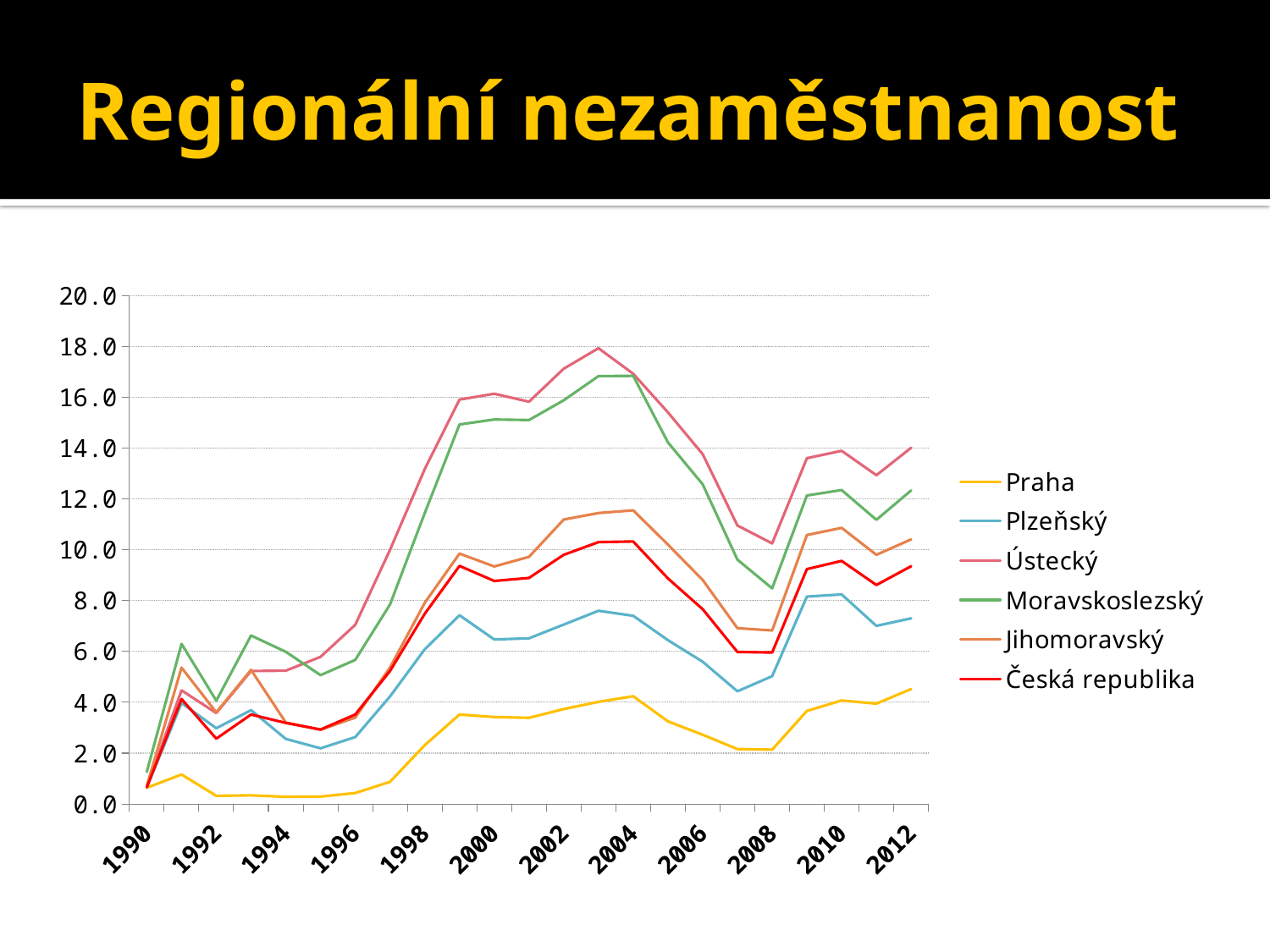
Does the Ústecký line rise or fall between 1996 and 1999? rise Does the Praha line rise or fall between 2004 and 2008? fall Which series reaches the highest value anywhere on the chart? Ústecký What kind of chart is shown on the slide? line chart Is the value for Plzeňský in 2010 greater or less than 6.0? greater Is the value for Praha in 2004 greater or less than 6.0? less Is the value for Ústecký in 2003 greater or less than 16.0? greater What is the highest value shown on the y axis? 20.0 Which series has the lowest values across the whole period? Praha In 2012, which is larger: the value for Moravskoslezský or for Jihomoravský? Moravskoslezský How many series does the legend list? 6